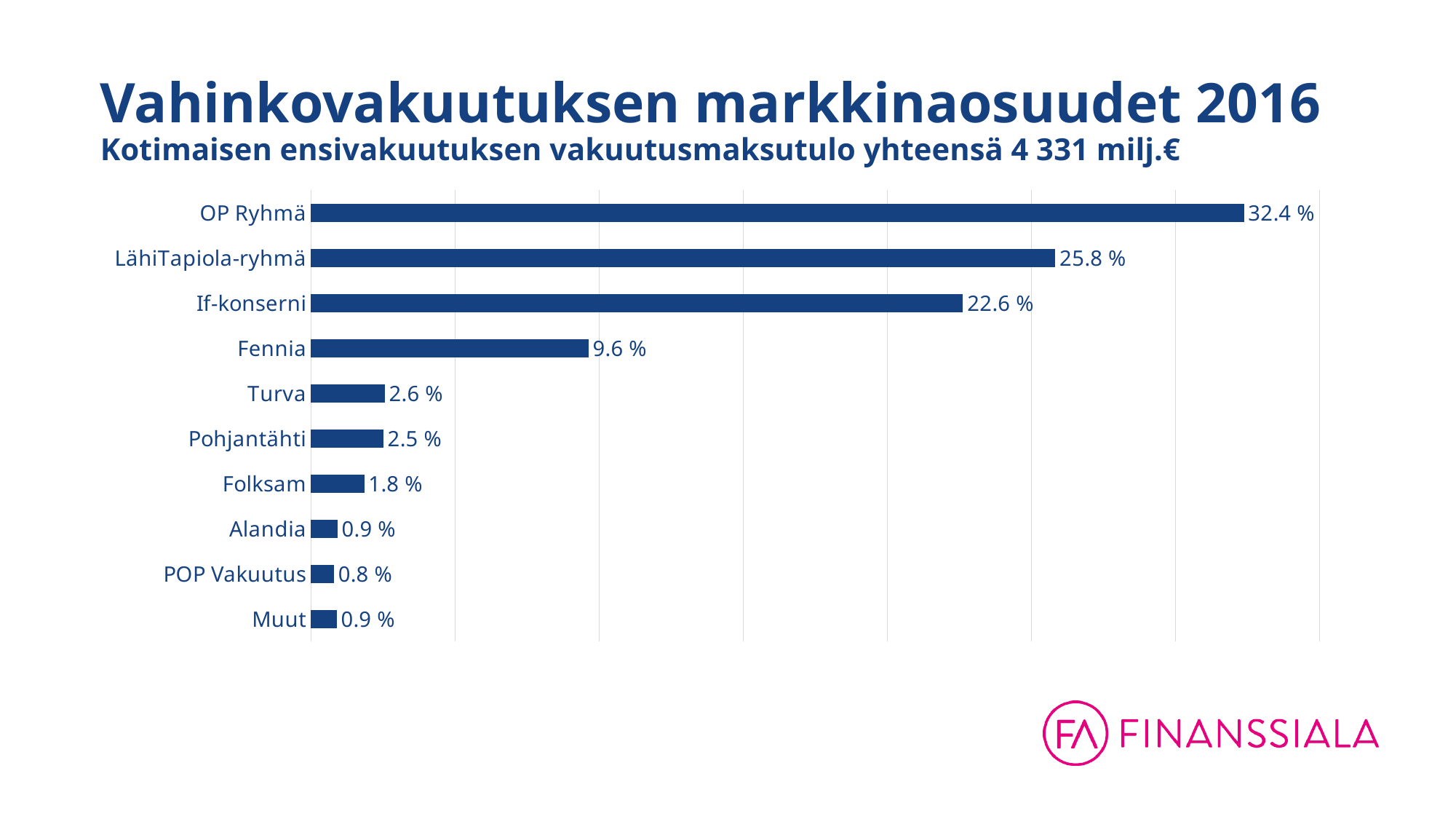
What is the difference between the market shares of If-konserni and Fennia? 13.0 % What is the market share shown for Fennia? 9.6 % What is the difference between the market shares of OP Ryhmä and LähiTapiola-ryhmä? 6.6 % Which category has the lowest market share? POP Vakuutus What is the title of the chart on the slide? Vahinkovakuutuksen markkinaosuudet 2016 Which has a larger market share, LähiTapiola-ryhmä or If-konserni? LähiTapiola-ryhmä Which category has the highest market share? OP Ryhmä Which has a larger market share, Turva or Pohjantähti? Turva How many categories are shown in the chart? 10 What kind of chart is shown on the slide? Bar chart What is the market share shown for OP Ryhmä? 32.4 % What is the market share shown for Folksam? 1.8 %